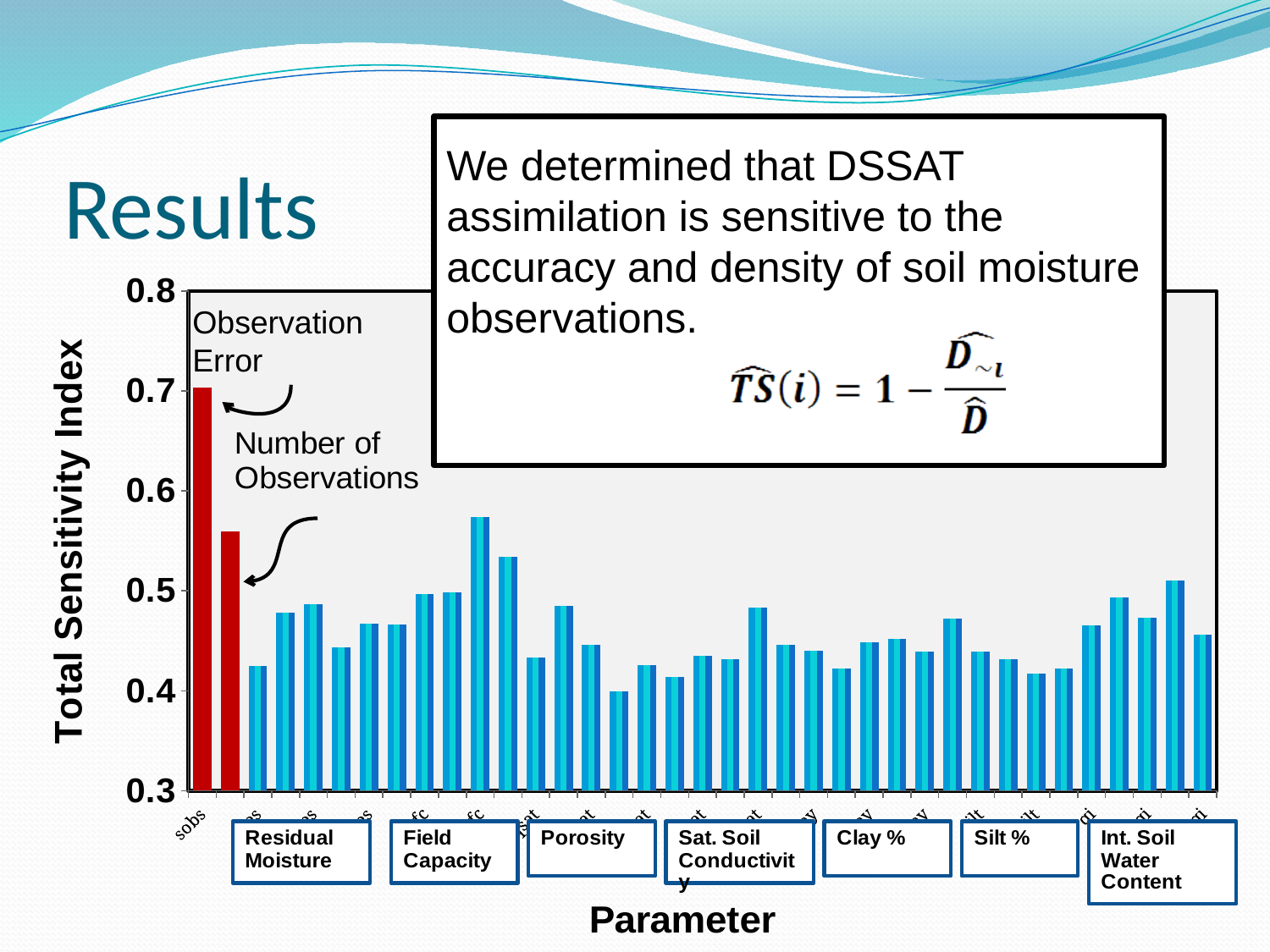
Is the Total Sensitivity Index for Number of Observations greater or less than 0.5? greater What is the title of the y axis? Total Sensitivity Index Is the Total Sensitivity Index for Observation Error greater or less than 0.6? greater Which labeled bar has the highest Total Sensitivity Index? Observation Error How many parameter groups are labeled in boxes below the x axis? 7 What kind of chart is shown on the slide? bar chart Is the tallest blue bar in the chart greater or less than 0.6? less What colour are the Observation Error and Number of Observations bars? red Which is larger, the Total Sensitivity Index for Observation Error or for Number of Observations? Observation Error